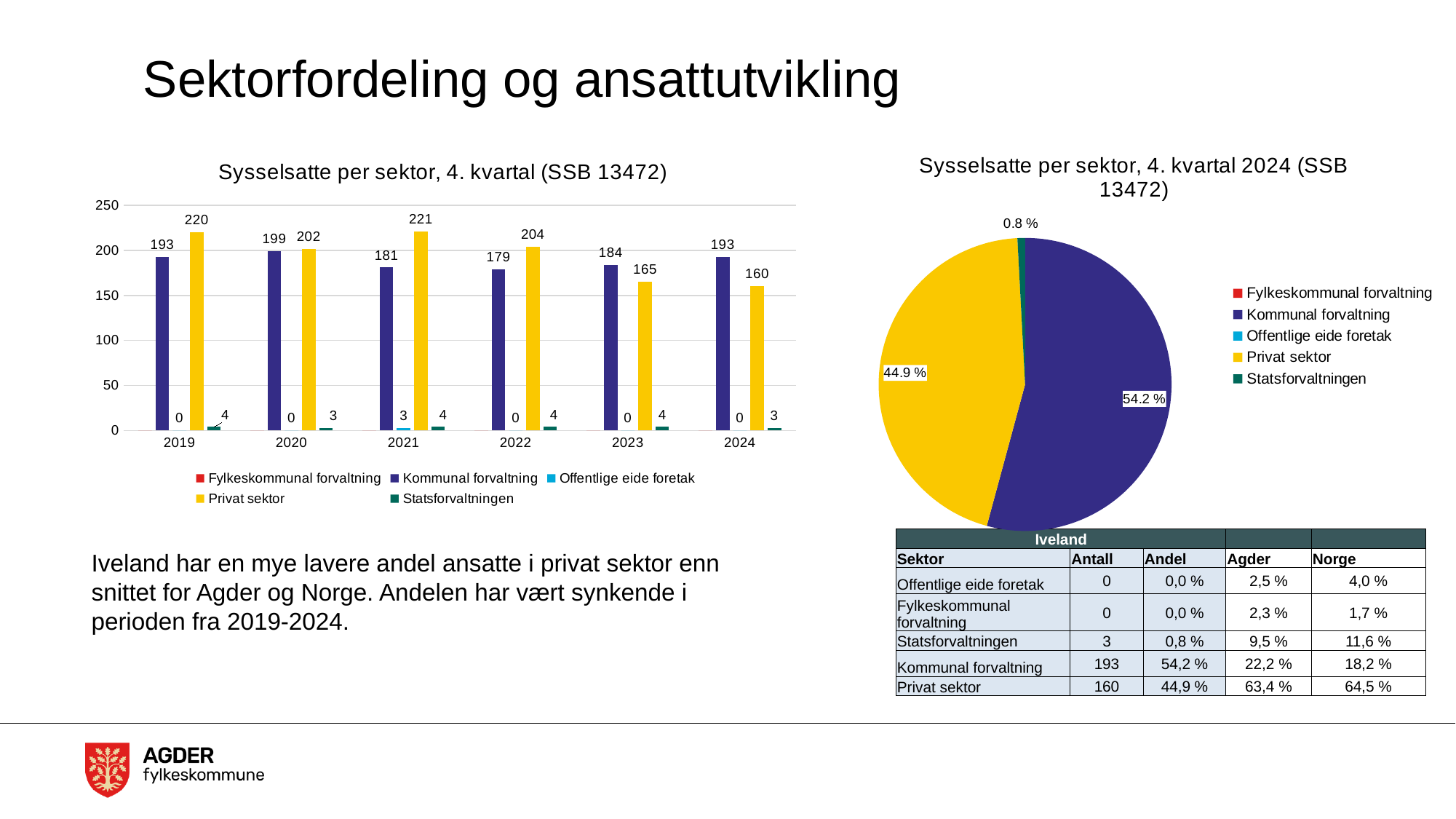
In the bar chart 'Sysselsatte per sektor, 4. kvartal (SSB 13472)', in which year is Privat sektor highest? 2021 In the bar chart 'Sysselsatte per sektor, 4. kvartal (SSB 13472)', does Privat sektor rise or fall from 2021 to 2024? fall In the bar chart 'Sysselsatte per sektor, 4. kvartal (SSB 13472)', what is the value for Privat sektor in 2019? 220 In the pie chart 'Sysselsatte per sektor, 4. kvartal 2024 (SSB 13472)', what share does Privat sektor have? 44.9 % In the bar chart 'Sysselsatte per sektor, 4. kvartal (SSB 13472)', how many series does the legend list? 5 What kind of chart is 'Sysselsatte per sektor, 4. kvartal (SSB 13472)' on the left of the slide? bar chart In the bar chart 'Sysselsatte per sektor, 4. kvartal (SSB 13472)', which is larger in 2023: Kommunal forvaltning or Privat sektor? Kommunal forvaltning In the bar chart 'Sysselsatte per sektor, 4. kvartal (SSB 13472)', what is the value for Kommunal forvaltning in 2022? 179 In the bar chart 'Sysselsatte per sektor, 4. kvartal (SSB 13472)', how many years are shown on the x axis? 6 In the bar chart 'Sysselsatte per sektor, 4. kvartal (SSB 13472)', in which year is Privat sektor lowest? 2024 In the bar chart 'Sysselsatte per sektor, 4. kvartal (SSB 13472)', what is the difference between Privat sektor in 2019 and in 2024? 60 In the pie chart 'Sysselsatte per sektor, 4. kvartal 2024 (SSB 13472)', what share does Kommunal forvaltning have? 54.2 %